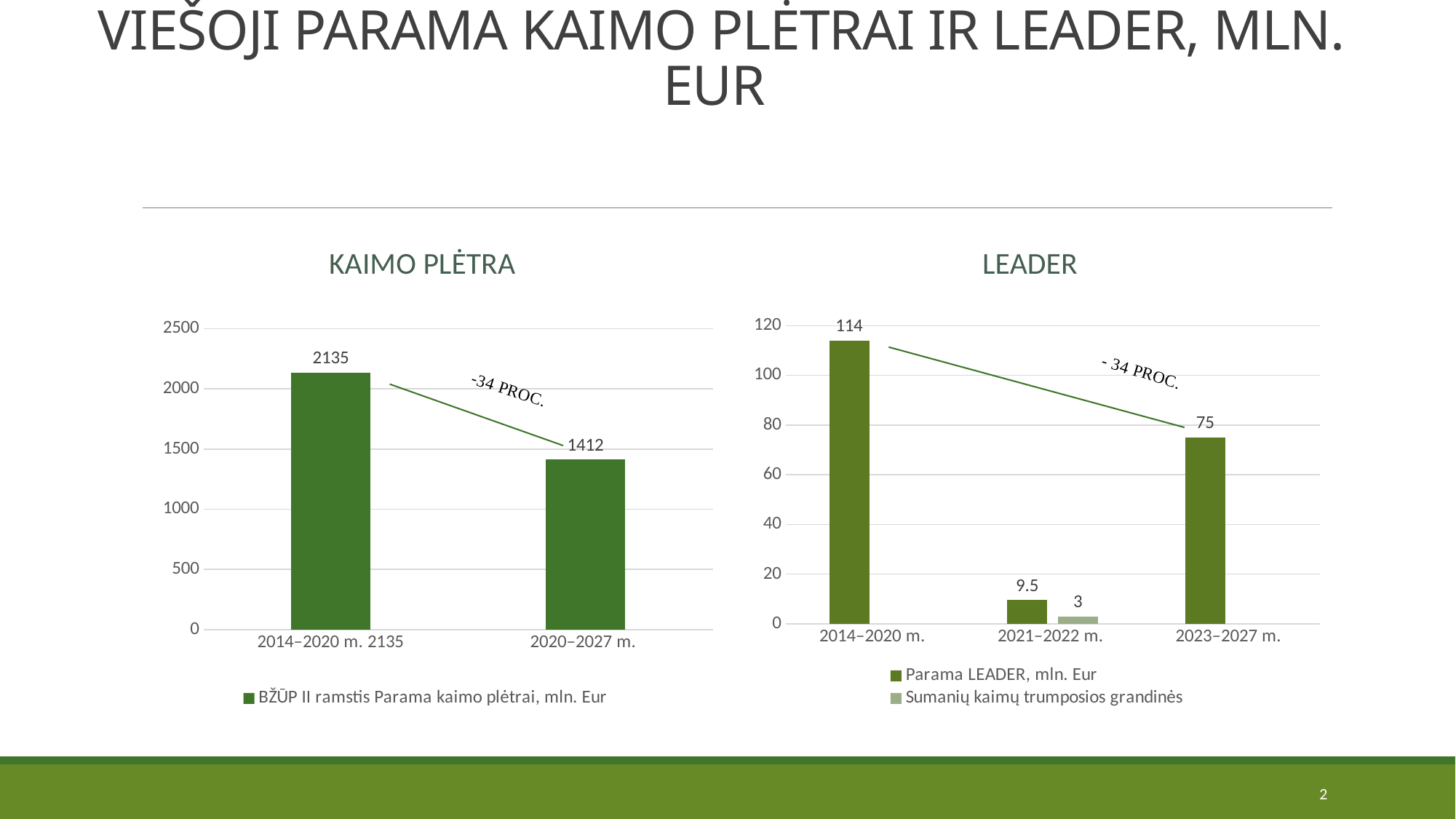
In the KAIMO PLĖTRA chart, what kind of chart is shown? Bar chart In the KAIMO PLĖTRA chart, do the values rise or fall from left to right? Fall In the LEADER chart, how many periods are shown on the x axis? 3 In the LEADER chart, what is the value of Parama LEADER, mln. Eur for 2014–2020 m.? 114 In the LEADER chart, what is the difference between the Parama LEADER values for 2014–2020 m. and 2023–2027 m.? 39 In the LEADER chart, how many series does the legend list? 2 In the KAIMO PLĖTRA chart, what is the value for 2020–2027 m.? 1412 In the KAIMO PLĖTRA chart, what is the difference between the 2014–2020 m. value and the 2020–2027 m. value? 723 In the KAIMO PLĖTRA chart, what is the value for the 2014–2020 m. bar? 2135 In the LEADER chart, what is the value of Parama LEADER, mln. Eur for 2021–2022 m.? 9.5 In the LEADER chart, which period has the highest Parama LEADER value? 2014–2020 m. In the LEADER chart, what is the value of Sumanių kaimų trumposios grandinės for 2021–2022 m.? 3